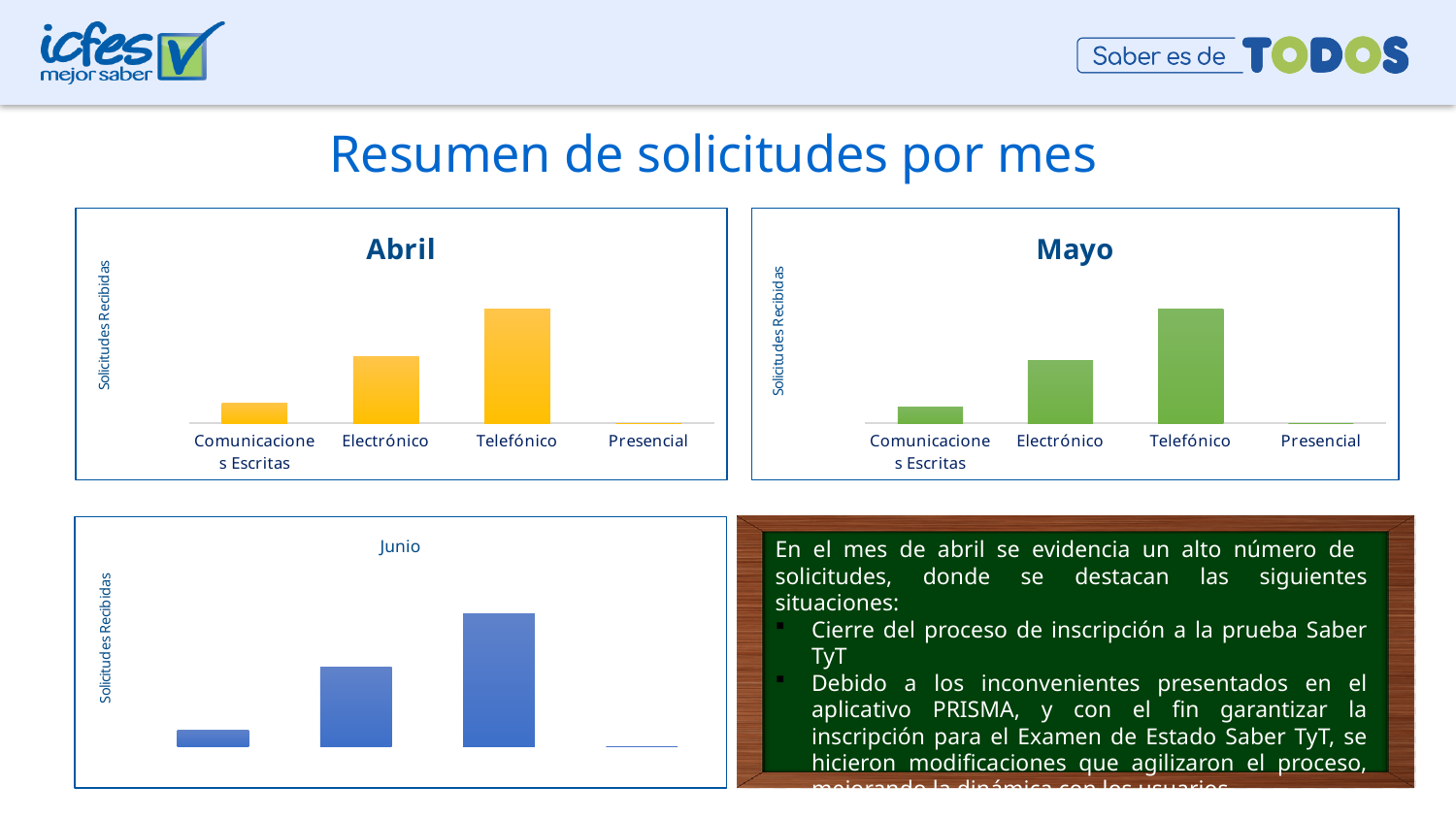
What kind of chart is the Abril chart? Bar chart What is the y-axis label of the Mayo chart? Solicitudes Recibidas What is the title of the chart in the bottom-left of the slide? Junio What kind of chart is the Junio chart? Bar chart In the Mayo chart, which category has the highest number of solicitudes recibidas? Telefónico In the Mayo chart, which category has the lowest number of solicitudes recibidas? Presencial How many categories are shown on the x axis of the Mayo chart? 4 In the Abril chart, which category has the lowest number of solicitudes recibidas? Presencial In the Mayo chart, which is larger, Telefónico or Electrónico? Telefónico In the Abril chart, which category has the highest number of solicitudes recibidas? Telefónico In the Abril chart, which is larger, Electrónico or Comunicaciones Escritas? Electrónico How many categories are shown on the x axis of the Abril chart? 4